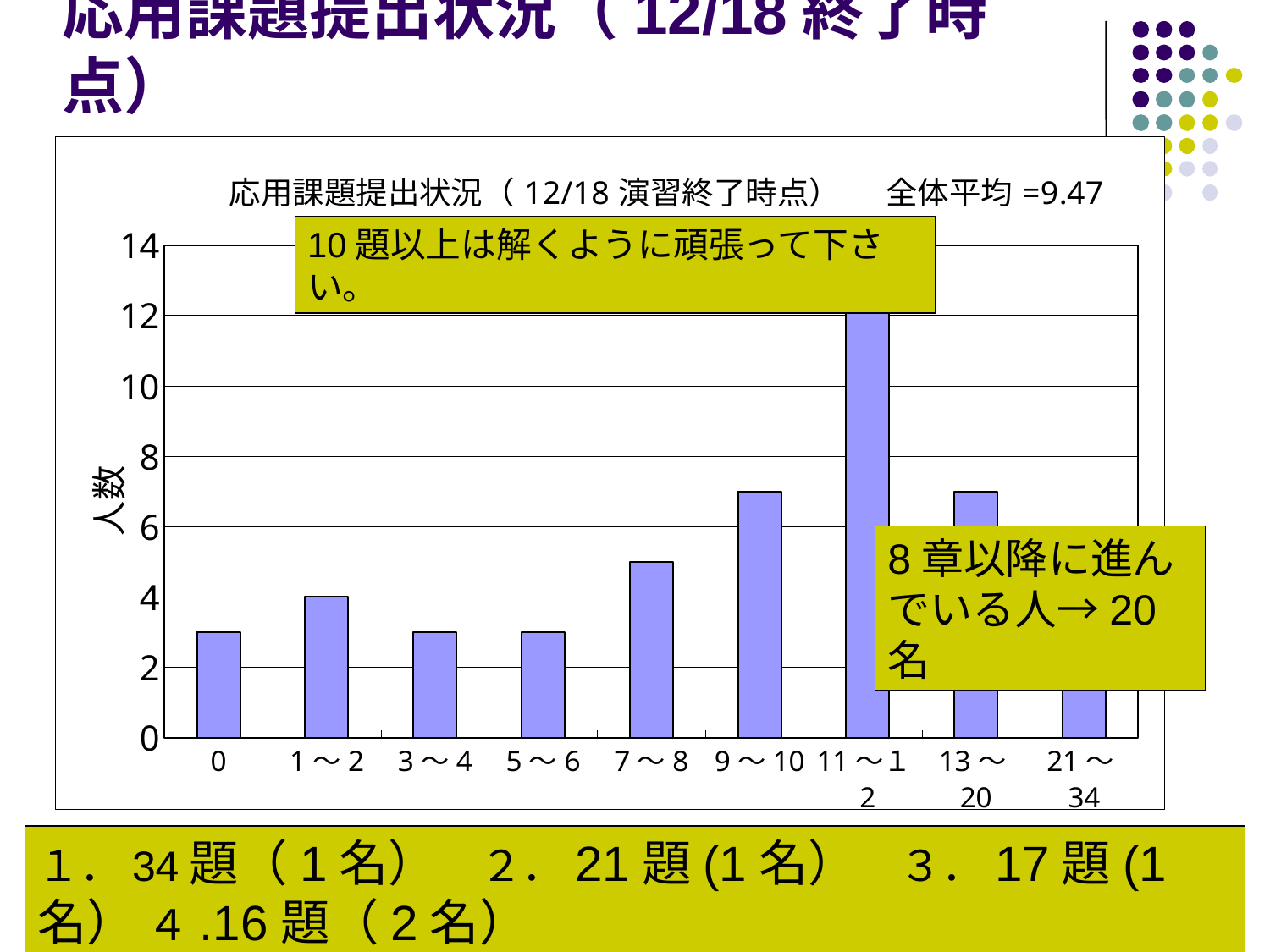
What overall average (全体平均) is stated in the chart title? 9.47 Is the value for the category 11～12 greater or less than 10? greater Is the value for the category 7～8 greater or less than 4? greater What kind of chart is shown on the slide? bar chart Is the value for the category 13～20 greater or less than 8? less What is the value (人数) for the category 1～2? 4 How many categories are shown on the x axis of the chart? 9 Which category has the larger value, 7～8 or 9～10? 9～10 Which category has the highest bar in the chart? 11～12 What is the label of the y axis of the chart? 人数